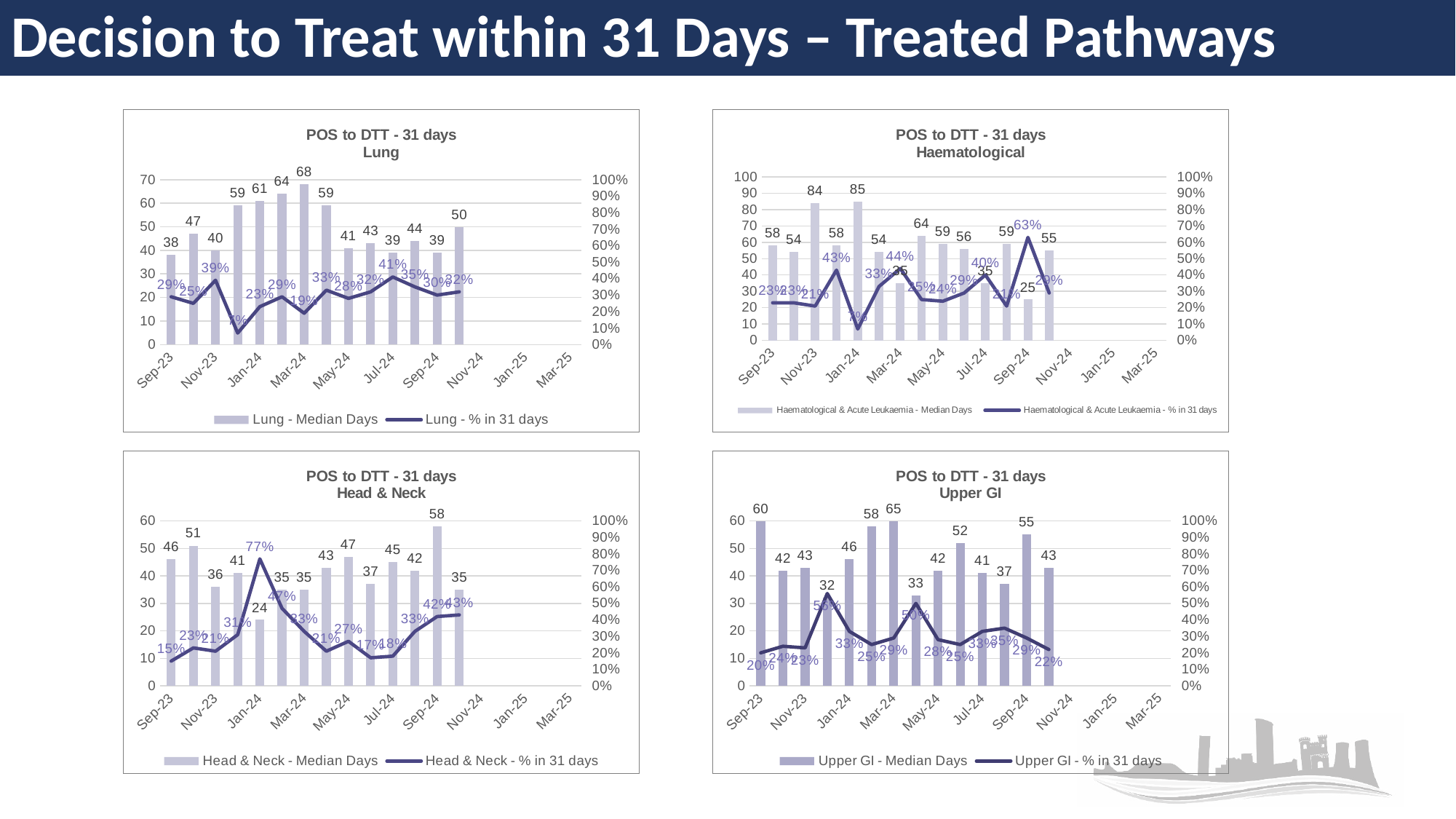
In the POS to DTT - 31 days Haematological chart, what is the highest % in 31 days value on the line? 63% In the POS to DTT - 31 days Haematological chart, what is the highest median days value shown? 85 What kind of chart is the POS to DTT - 31 days Upper GI chart? Combined bar and line chart In the POS to DTT - 31 days Lung chart, what is the median days value for Sep-23? 38 In the POS to DTT - 31 days Head & Neck chart, what is the median days value for Jan-24? 24 In the POS to DTT - 31 days Head & Neck chart, what is the % in 31 days value for Jan-24? 77% In the POS to DTT - 31 days Lung chart, what is the difference between the Mar-24 median days (68) and the Sep-23 median days (38)? 30 How many series does the legend of the POS to DTT - 31 days Lung chart list? 2 In the POS to DTT - 31 days Upper GI chart, what is the median days value for Sep-24? 55 In the POS to DTT - 31 days Lung chart, which month has the highest median days bar? Mar-24 In the POS to DTT - 31 days Upper GI chart, which is larger: the median days for Sep-23 or for Mar-24? Mar-24 In the POS to DTT - 31 days Haematological chart, what is the lowest median days value shown? 25